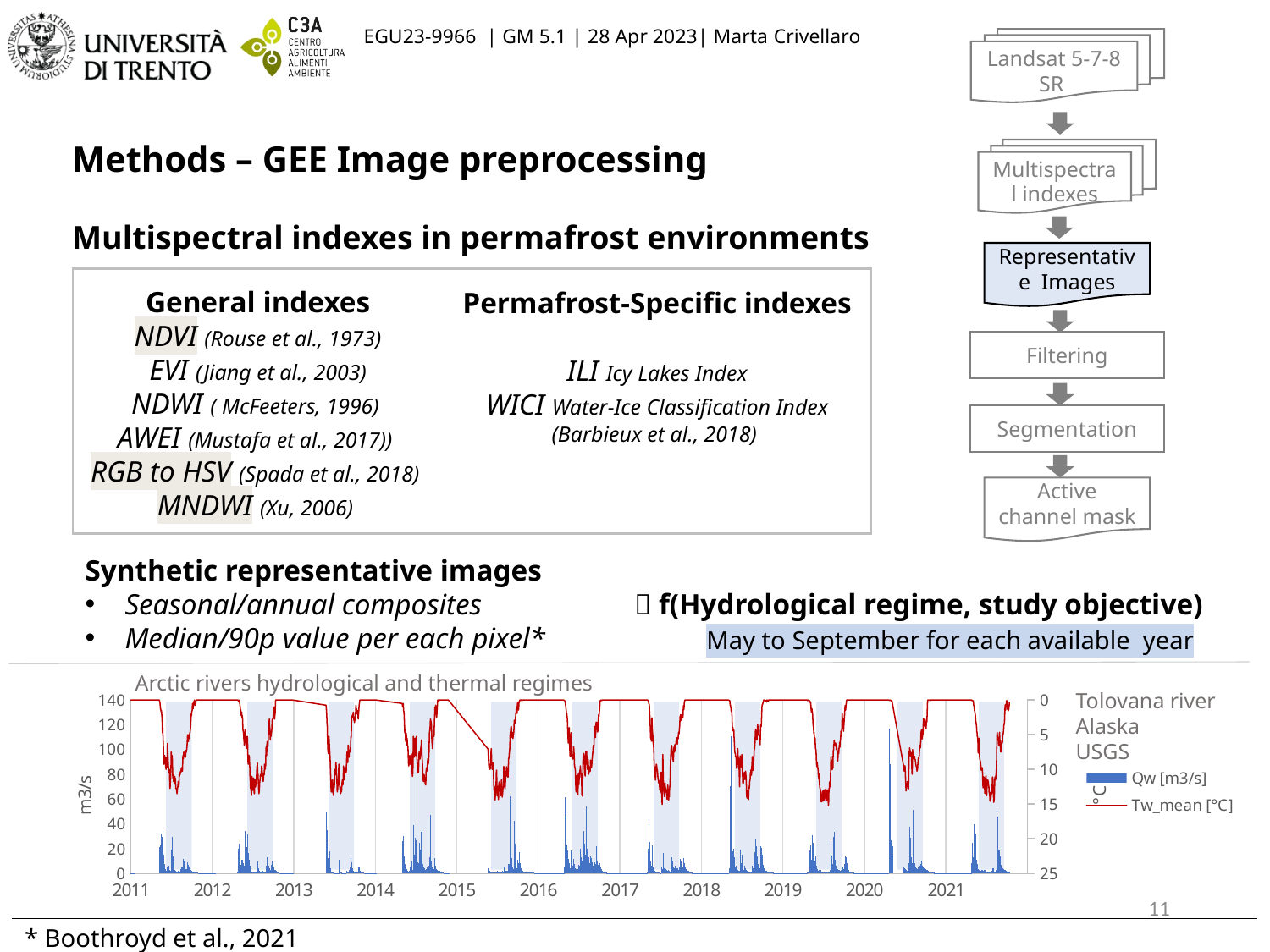
How many year labels are shown on the x axis of the 'Arctic rivers hydrological and thermal regimes' chart? 11 In the 'Arctic rivers hydrological and thermal regimes' chart, is the peak Qw value in 2011 greater or less than 60 m3/s? less What are the two legend entries of the 'Arctic rivers hydrological and thermal regimes' chart? Qw [m3/s] and Tw_mean [°C] How many series does the legend of the 'Arctic rivers hydrological and thermal regimes' chart list? 2 In the 'Arctic rivers hydrological and thermal regimes' chart, is the peak Qw value in 2020 greater or less than 80 m3/s? greater What is the maximum value shown on the left (m3/s) axis of the 'Arctic rivers hydrological and thermal regimes' chart? 140 What kind of chart is used to plot Tw_mean [°C] in the 'Arctic rivers hydrological and thermal regimes' chart? line chart In the 'Arctic rivers hydrological and thermal regimes' chart, is the peak Qw value in 2012 greater or less than 100 m3/s? less